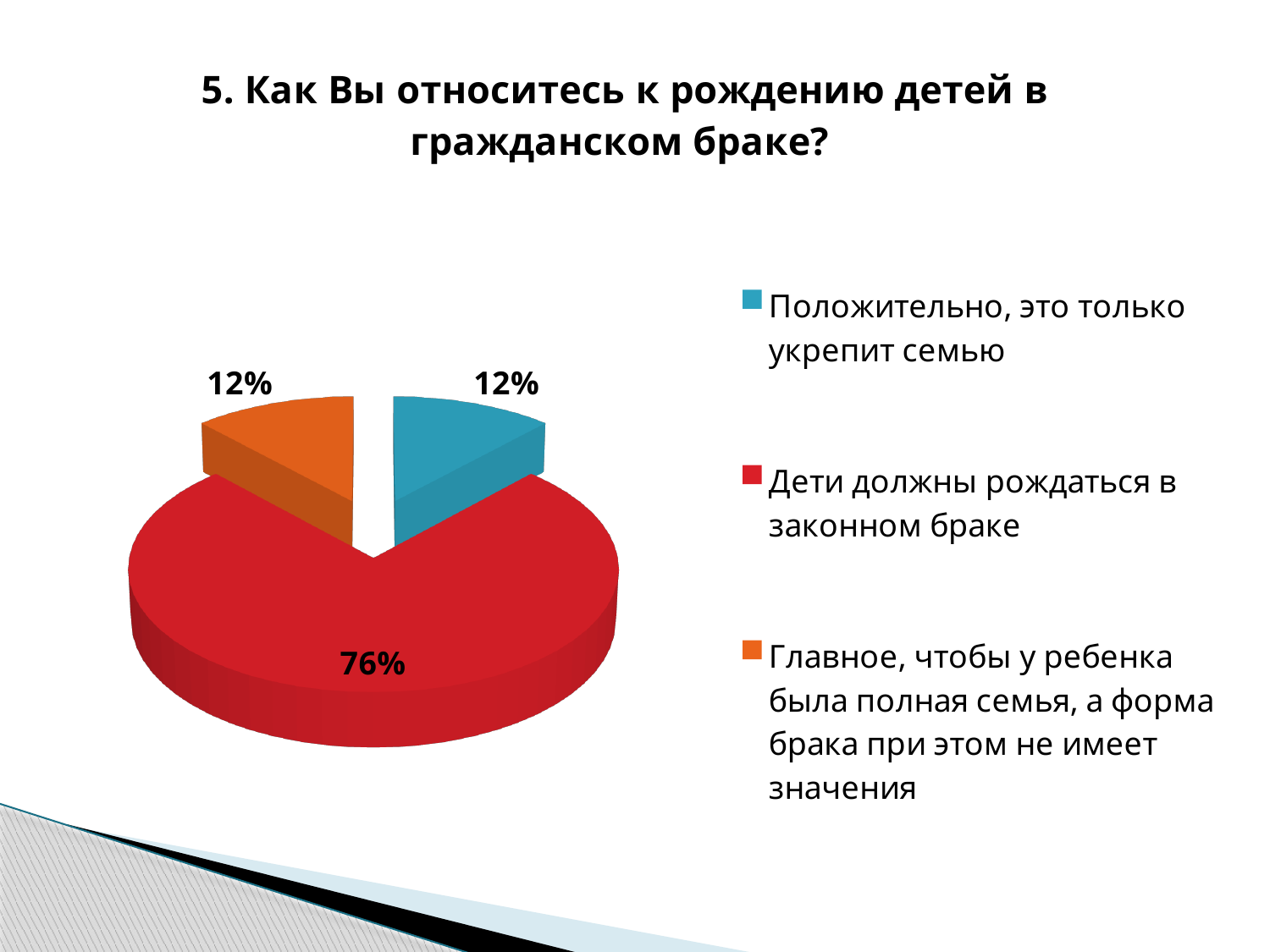
What is the title of the chart? 5. Как Вы относитесь к рождению детей в гражданском браке? Which is larger: the share for "Дети должны рождаться в законном браке" or the share for "Главное, чтобы у ребенка была полная семья, а форма брака при этом не имеет значения"? Дети должны рождаться в законном браке Which category has the largest slice of the pie? Дети должны рождаться в законном браке How many entries does the legend list? 3 What colour is the slice for "Дети должны рождаться в законном браке"? red What is the combined share of the two 12% slices? 24% What share of the pie does "Положительно, это только укрепит семью" have? 12% What is the difference between the share for "Дети должны рождаться в законном браке" and the share for "Положительно, это только укрепит семью"? 64% What share of the pie does "Главное, чтобы у ребенка была полная семья, а форма брака при этом не имеет значения" have? 12% What share of the pie does "Дети должны рождаться в законном браке" have? 76% How many slices does the pie chart have? 3 What kind of chart is shown on the slide? pie chart